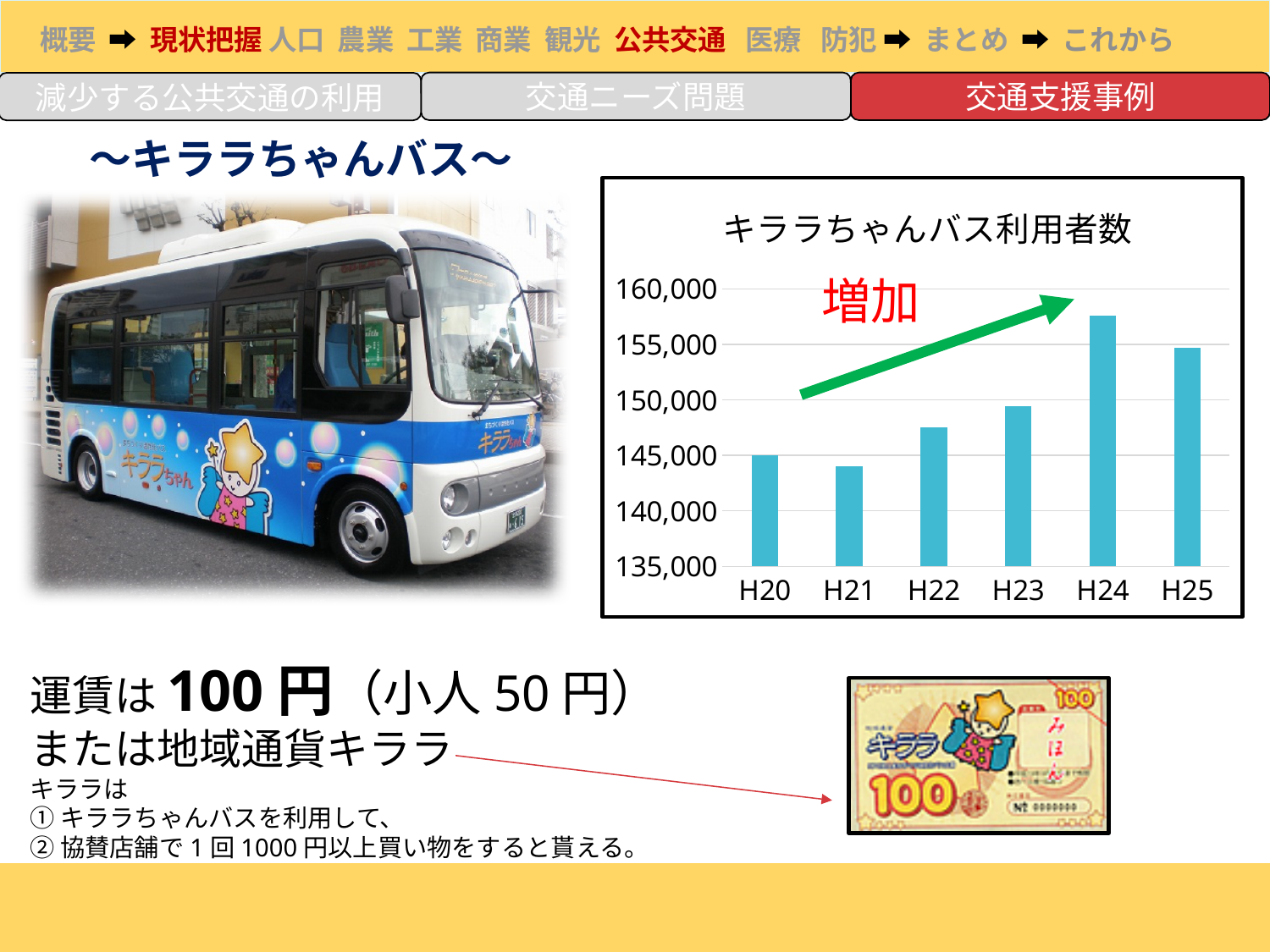
Do the values in the chart generally rise or fall from H20 to H25? rise How many categories (years) are shown on the x axis of the chart? 6 Which year has the lowest number of users in the chart? H21 Is the value for H24 greater or less than 155,000? greater Which is larger, the value for H24 or the value for H25? H24 What kind of chart is shown on the slide? bar chart Which year has the highest number of users in the chart? H24 Is the value for H23 greater or less than 150,000? less Is the value for H21 greater or less than 145,000? less What is the title of the chart? キララちゃんバス利用者数 Which is larger, the value for H22 or the value for H23? H23